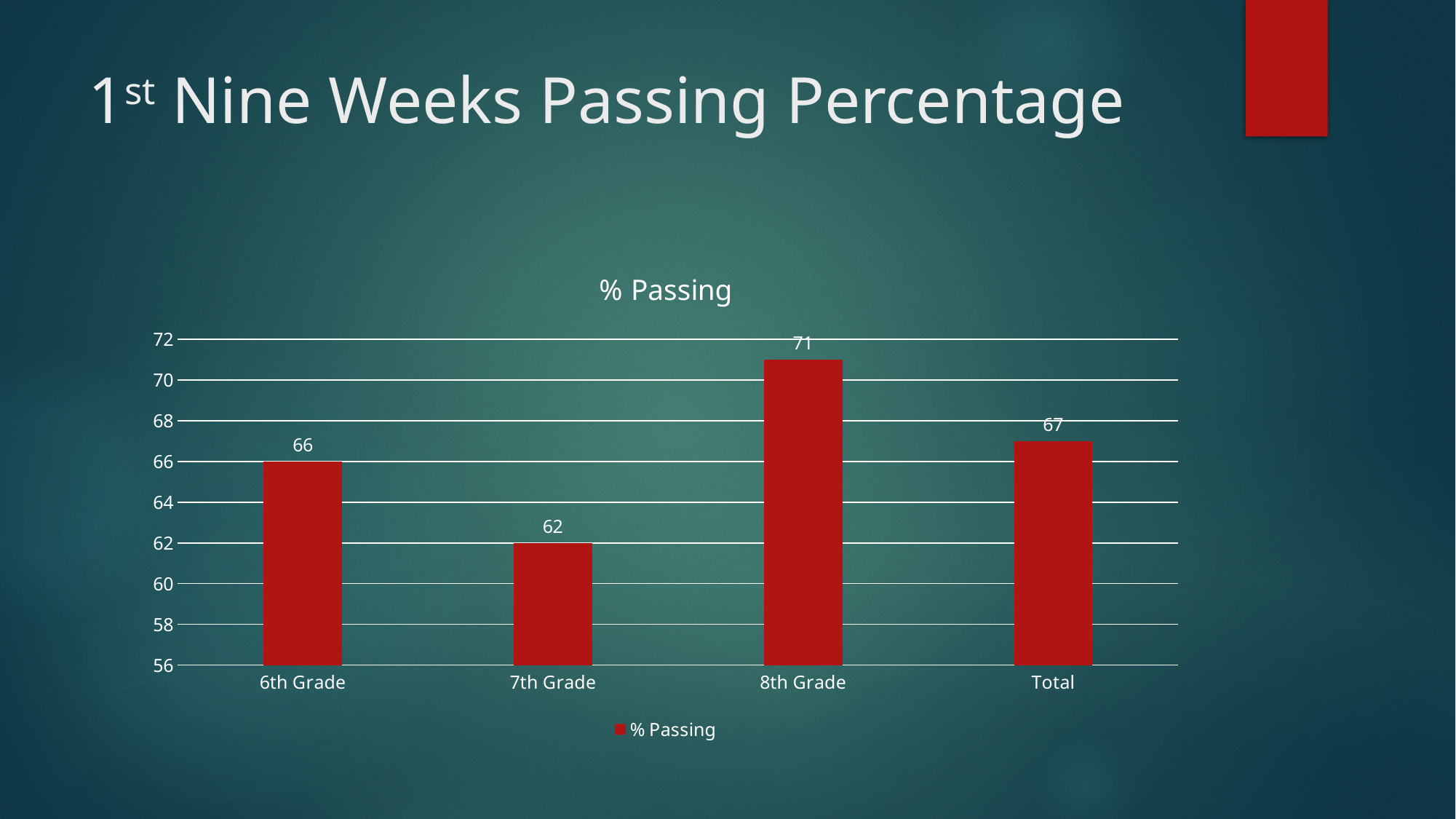
What is the % Passing value for 7th Grade? 62 What is the % Passing value for Total? 67 Which has a higher % Passing, 6th Grade or Total? Total Which category has the lowest % Passing? 7th Grade Is the value for 8th Grade greater or less than 70? greater What is the title of the chart? % Passing What kind of chart is shown on the slide? Bar chart What is the % Passing value for 6th Grade? 66 Which category has the highest % Passing? 8th Grade How many categories are shown on the x axis? 4 What is the difference in % Passing between 8th Grade and 7th Grade? 9 What is the % Passing value for 8th Grade? 71